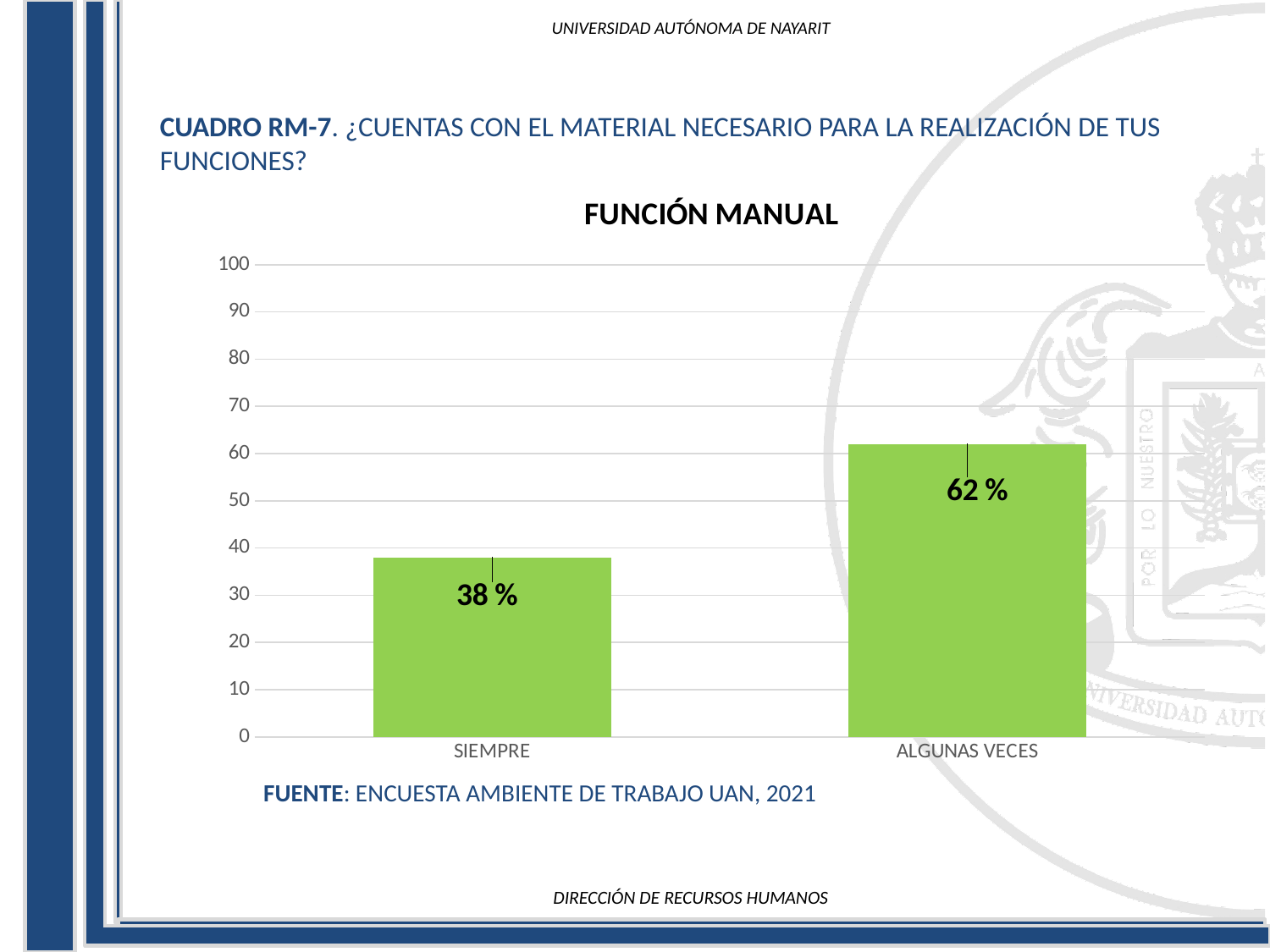
What is the difference between the values for ALGUNAS VECES and SIEMPRE? 24 % What is the highest value shown on the vertical axis? 100 Is the value for ALGUNAS VECES greater or less than 60? greater What is the value for SIEMPRE? 38 % How many categories are shown on the x axis? 2 Is the value for SIEMPRE greater or less than 40? less Which is larger, the value for SIEMPRE or the value for ALGUNAS VECES? ALGUNAS VECES Which category has the lowest value? SIEMPRE What is the title of the chart? FUNCIÓN MANUAL What is the value for ALGUNAS VECES? 62 % What kind of chart is shown on the slide? bar chart Which category has the highest value? ALGUNAS VECES